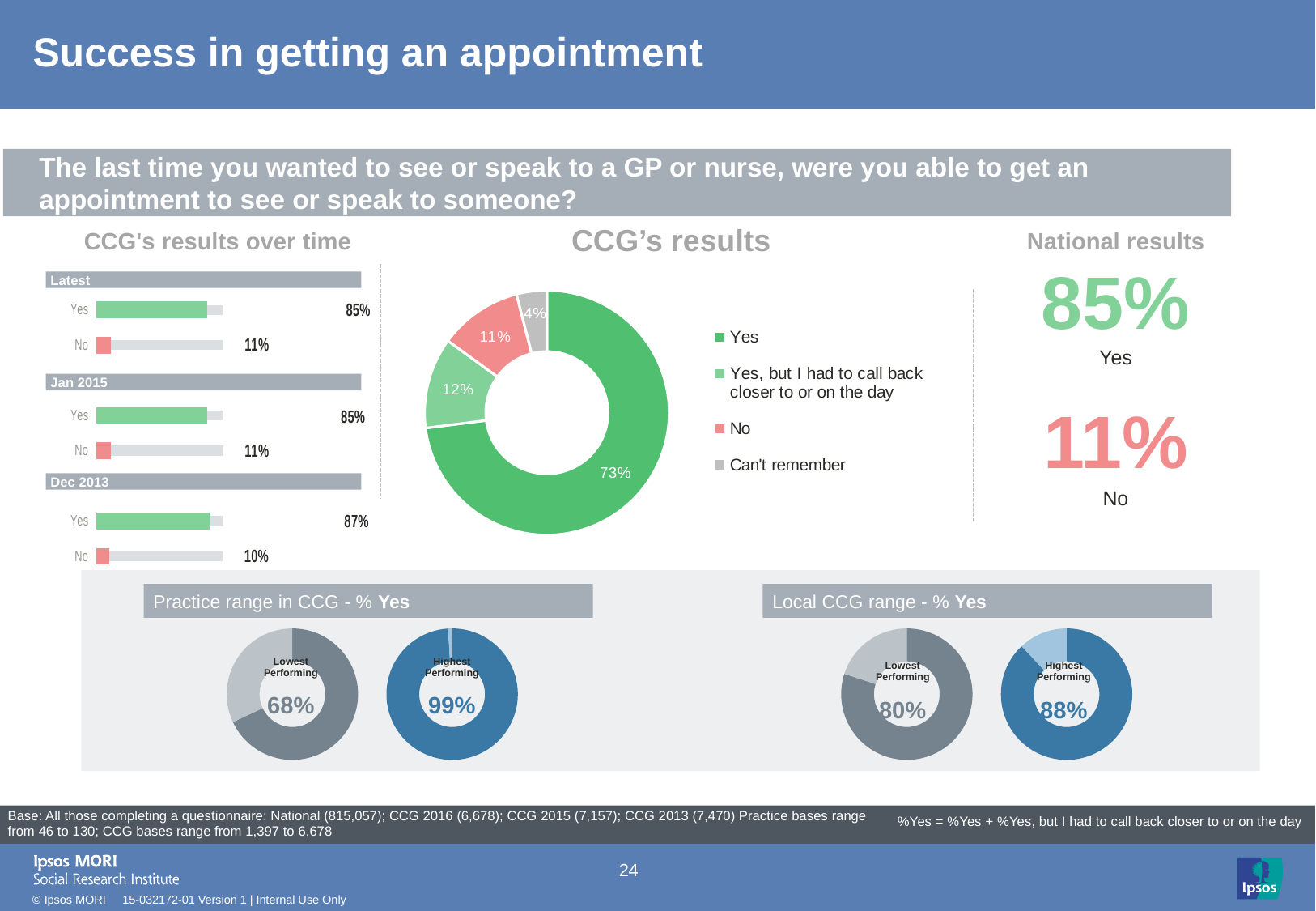
In the "CCG's results" donut chart, what percentage answered "Yes"? 73% In the "CCG's results" chart, what is the difference between the "Yes" share and the "No" share? 62 percentage points In the "CCG's results" donut chart, what percentage answered "Can't remember"? 4% In the "CCG's results over time" chart, what was the "Yes" value in Dec 2013? 87% In the "CCG's results over time" chart, which is larger: the "Yes" value for Dec 2013 or for Latest? Dec 2013 In the "Local CCG range - % Yes" section, what is the difference between the Highest Performing and Lowest Performing values? 8 percentage points In the "CCG's results" chart, which response has the largest share? Yes What kind of chart is used for "CCG's results"? Pie (donut) chart In the "CCG's results" chart, which response has the smallest share? Can't remember How many response categories does the legend of the "CCG's results" chart list? 4 In the "Practice range in CCG - % Yes" section, what is the Highest Performing value? 99% What kind of chart is "CCG's results over time"? Bar chart